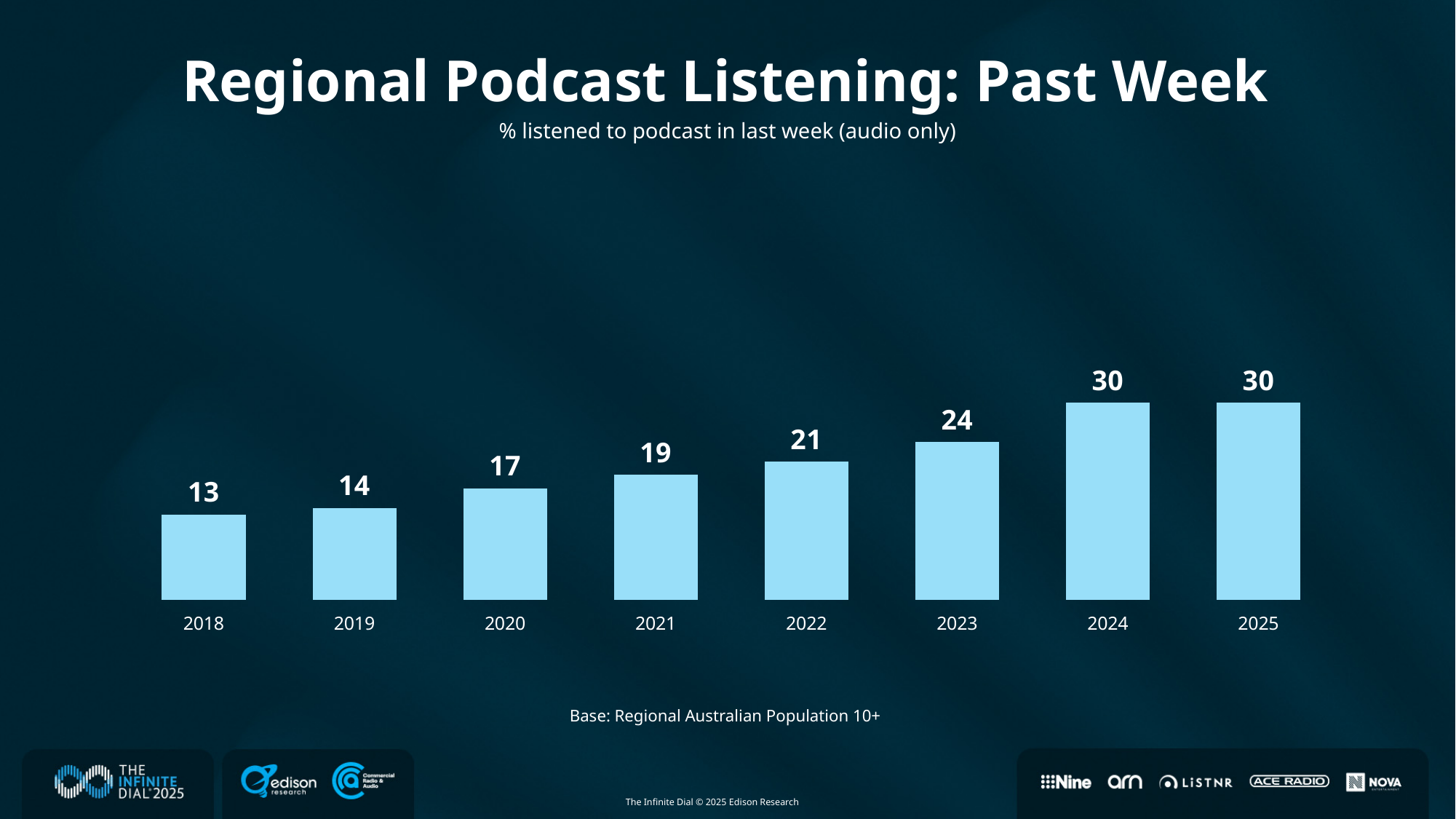
What is the difference between the values for 2023 and 2022? 3 What is the difference between the values for 2025 and 2018? 17 What is the value for 2021? 19 How many years are shown on the chart? 8 Which year has the lowest value? 2018 Which is larger, the value for 2020 or the value for 2022? 2022 What is the value for 2025? 30 Do the values rise or fall from 2018 to 2025? Rise What is the title of the chart? Regional Podcast Listening: Past Week What is the value for 2018? 13 What kind of chart is shown on the slide? Bar chart What is the value for 2023? 24